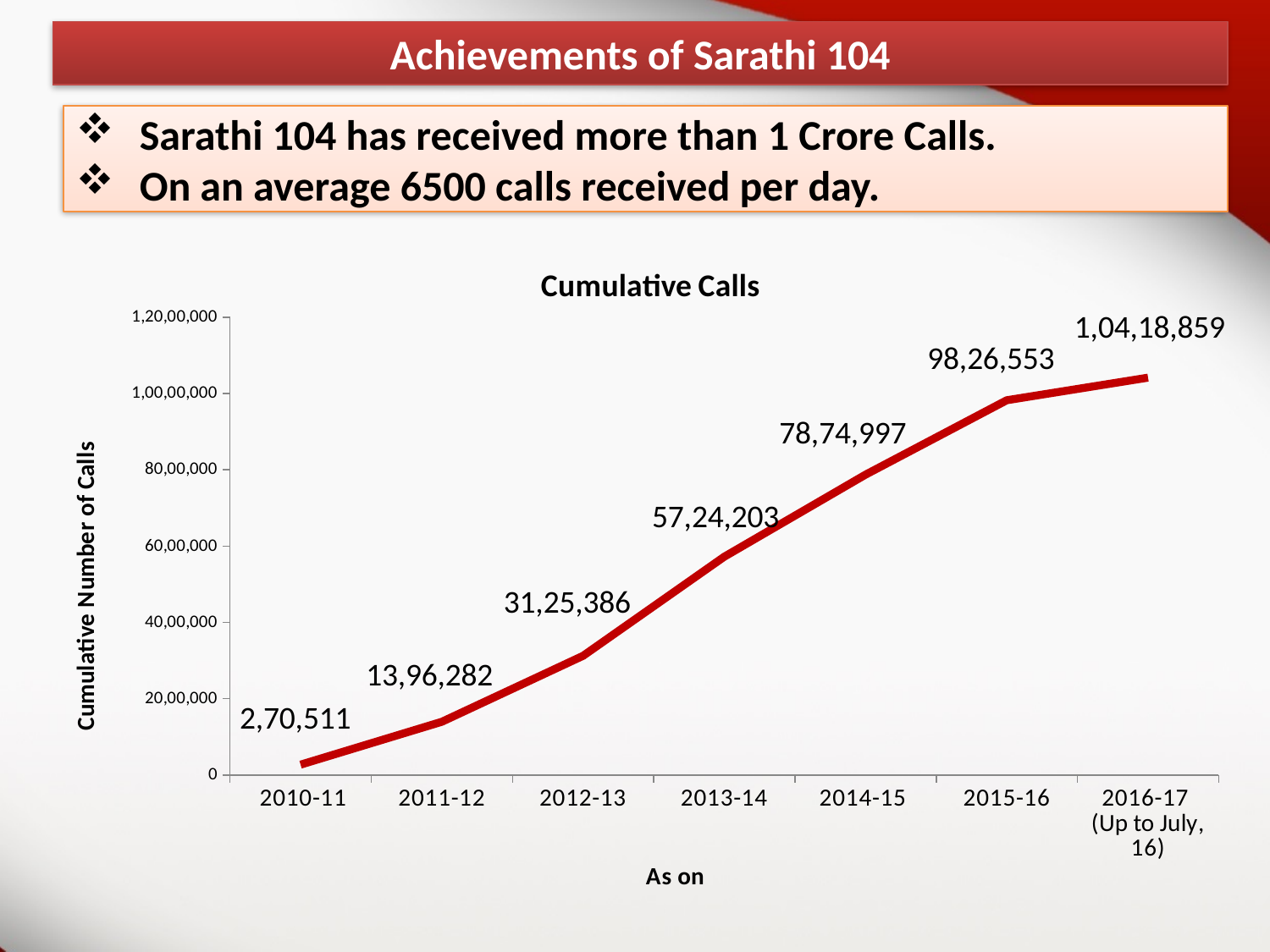
How many data points are plotted on the Cumulative Calls chart? 7 Which has more cumulative calls, 2014-15 or 2013-14? 2014-15 What is the cumulative number of calls for 2012-13? 31,25,386 What is the cumulative number of calls for 2010-11? 2,70,511 What is the cumulative number of calls for 2016-17 (Up to July, 16)? 1,04,18,859 What is the difference in cumulative calls between 2013-14 and 2012-13? 25,98,817 Which period has the highest cumulative number of calls? 2016-17 (Up to July, 16) Do the cumulative calls rise or fall from 2010-11 to 2016-17? rise What is the difference in cumulative calls between 2016-17 (Up to July, 16) and 2015-16? 5,92,306 Which period has the lowest cumulative number of calls? 2010-11 What kind of chart is used to show Cumulative Calls? line chart Is the cumulative number of calls for 2014-15 greater or less than 60,00,000? greater